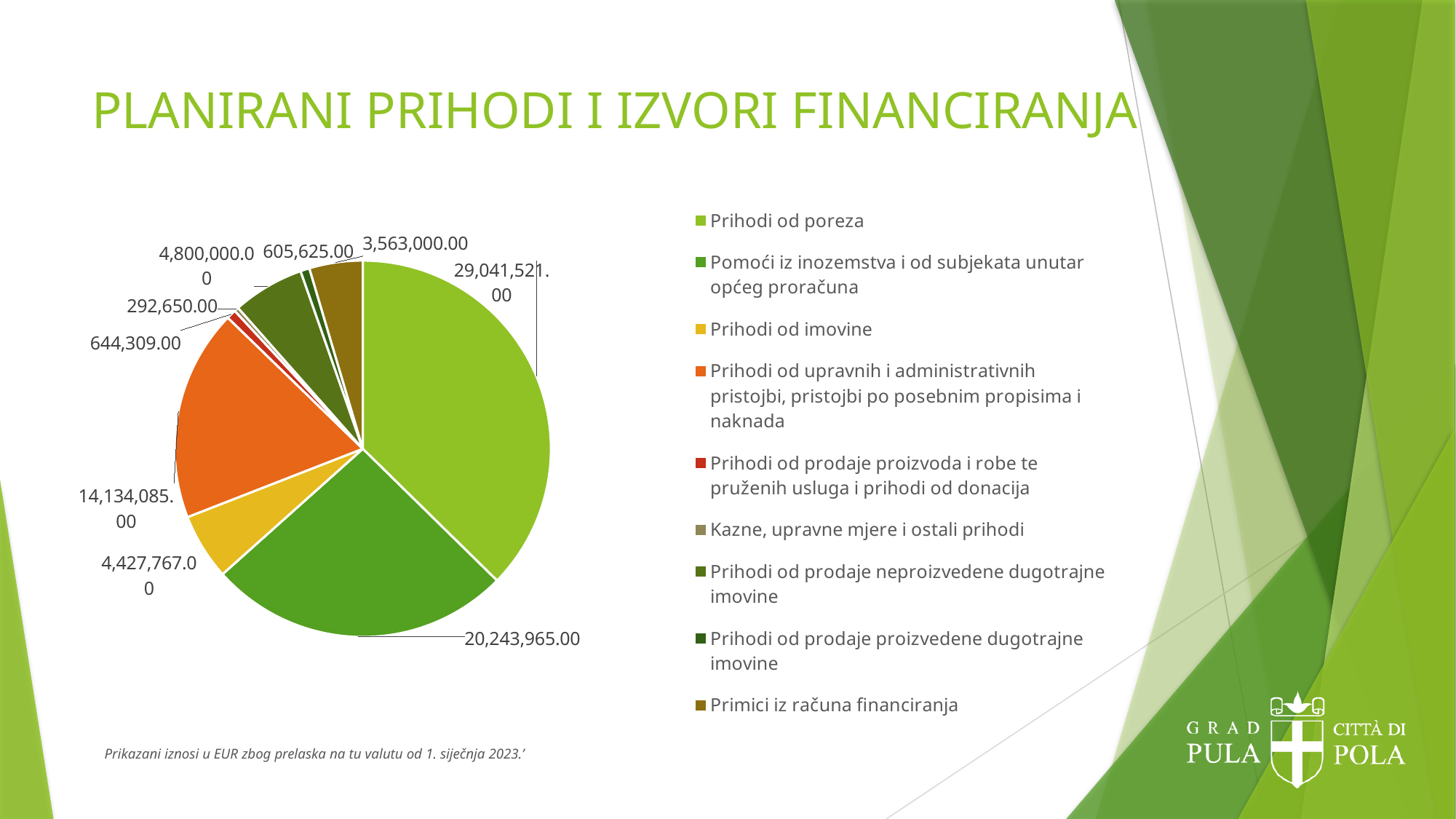
What is the value for Prihodi od poreza? 29,041,521.00 What kind of chart is shown on the slide? Pie chart What is the difference between Prihodi od poreza and Pomoći iz inozemstva i od subjekata unutar općeg proračuna? 8,797,556.00 What is the value for Prihodi od prodaje neproizvedene dugotrajne imovine? 4,800,000.00 Which category has the largest slice of the pie? Prihodi od poreza What is the value for Prihodi od imovine? 4,427,767.00 What is the title of the slide containing the pie chart? PLANIRANI PRIHODI I IZVORI FINANCIRANJA What is the value for Prihodi od upravnih i administrativnih pristojbi, pristojbi po posebnim propisima i naknada? 14,134,085.00 How many categories does the pie chart show? 9 Which is larger, Prihodi od imovine or Prihodi od upravnih i administrativnih pristojbi, pristojbi po posebnim propisima i naknada? Prihodi od upravnih i administrativnih pristojbi, pristojbi po posebnim propisima i naknada What is the value for Primici iz računa financiranja? 3,563,000.00 What is the value for Pomoći iz inozemstva i od subjekata unutar općeg proračuna? 20,243,965.00